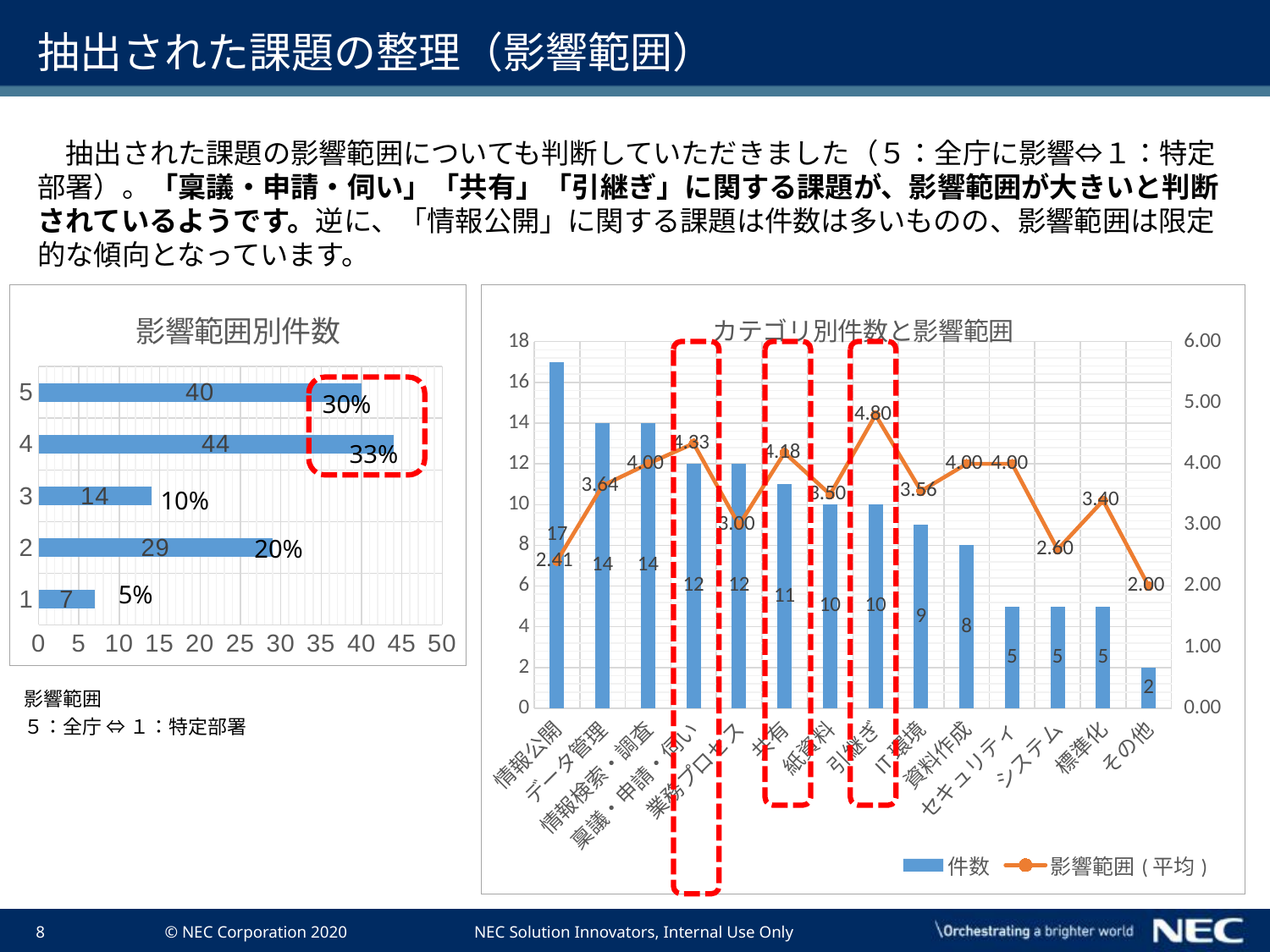
In the chart titled カテゴリ別件数と影響範囲, what is the difference between the 影響範囲(平均) values for 稟議・申請・伺い and 業務プロセス? 1.33 In the chart titled カテゴリ別件数と影響範囲, which category has the highest 影響範囲(平均) value? 引継ぎ In the chart titled 影響範囲別件数, how many categories are plotted? 5 In the chart titled カテゴリ別件数と影響範囲, what is the 影響範囲(平均) value for 引継ぎ? 4.80 In the chart titled 影響範囲別件数, which category has the lowest count? 1 In the chart titled カテゴリ別件数と影響範囲, which is larger, the 件数 for 共有 or the 件数 for IT環境? 共有 In the chart titled 影響範囲別件数, what percentage is shown next to category 5? 30% In the chart titled 影響範囲別件数, what is the value for category 4? 44 In the chart titled カテゴリ別件数と影響範囲, what is the 件数 value for 情報公開? 17 In the chart titled 影響範囲別件数, what is the difference between the values for category 4 and category 2? 15 In the chart titled カテゴリ別件数と影響範囲, how many series does the legend list? 2 In the chart titled カテゴリ別件数と影響範囲, which category has the lowest 件数? その他